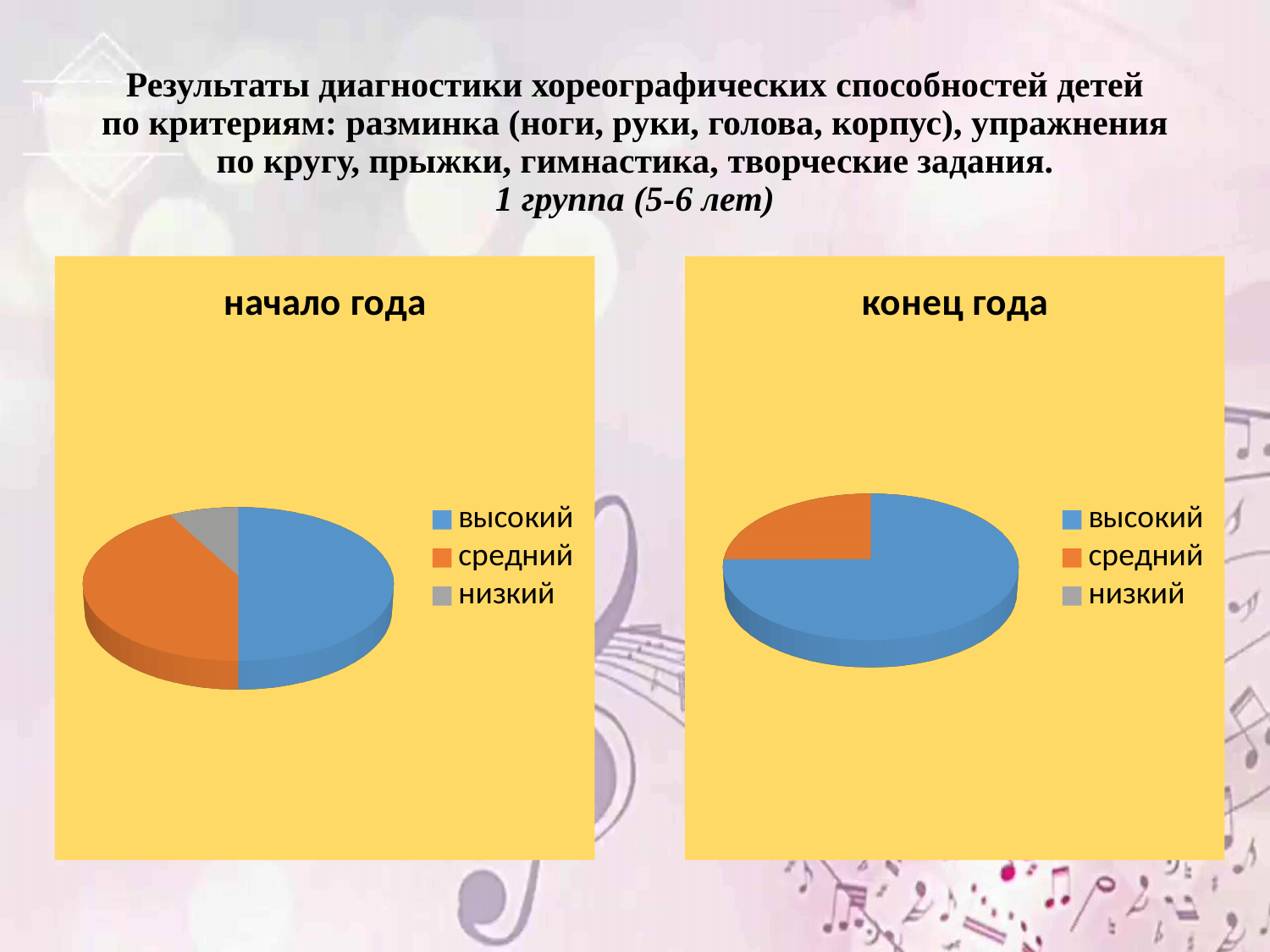
What kind of chart is the chart titled "начало года"? pie chart What kind of chart is the chart titled "конец года"? pie chart In the chart titled "начало года", what colour represents the category "средний"? orange In the chart titled "начало года", which category has the largest slice? высокий In the chart titled "конец года", how many categories does the legend list? 3 What is the title of the chart on the right side of the slide? конец года In the chart titled "конец года", which category has the largest slice? высокий In the chart titled "конец года", which is larger: высокий or средний? высокий In the chart titled "начало года", which category has the smallest slice? низкий In the chart titled "начало года", how many categories does the legend list? 3 How many charts are shown on the slide? 2 In the chart titled "начало года", which is larger: средний or низкий? средний